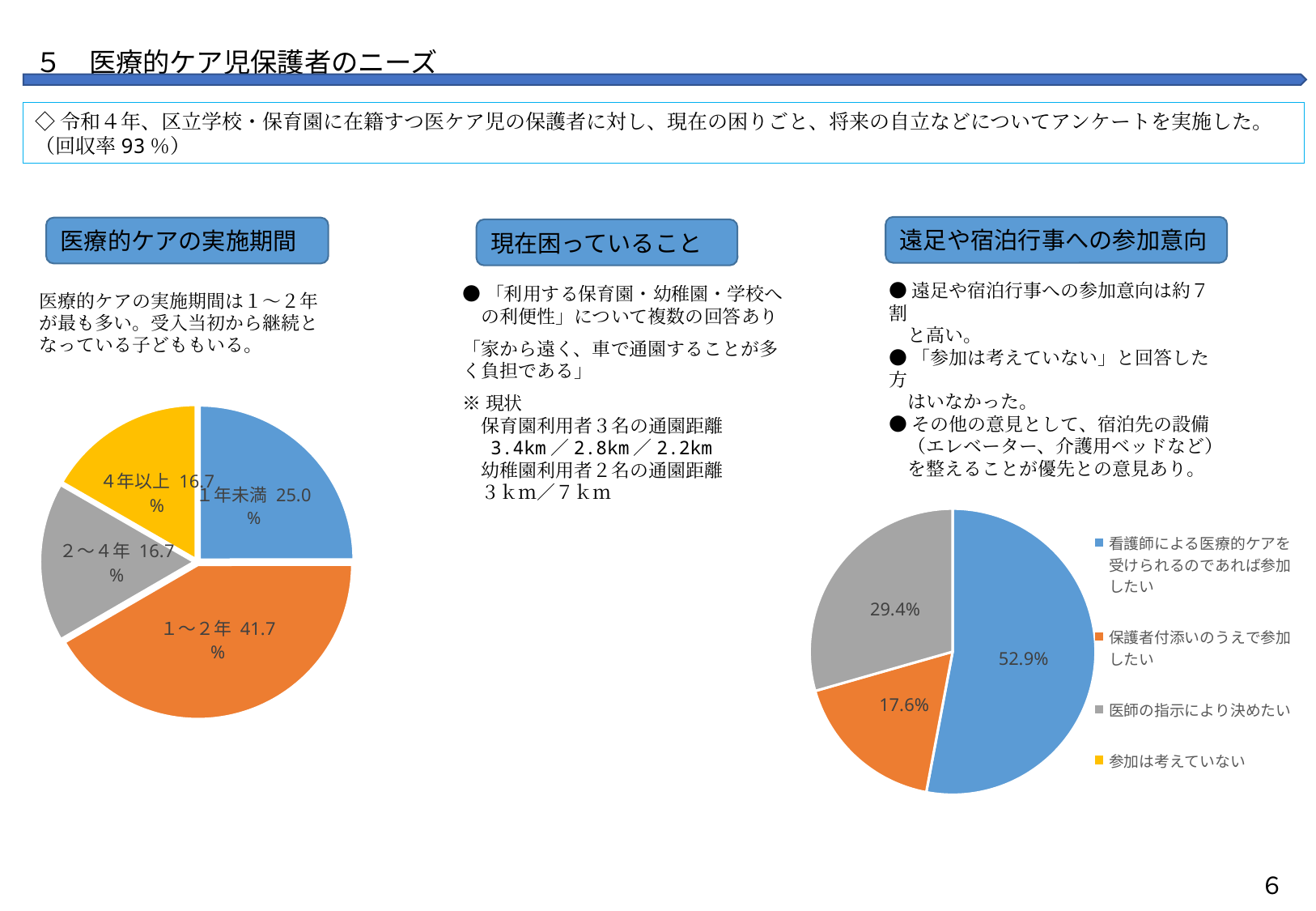
In the left pie chart (医療的ケアの実施期間), what is the difference between the shares for 1～2年 and 1年未満? 16.7% In the right pie chart (遠足や宿泊行事への参加意向), which is larger: 医師の指示により決めたい or 保護者付添いのうえで参加したい? 医師の指示により決めたい In the left pie chart (医療的ケアの実施期間), which category has the largest share? 1～2年 In the right pie chart (遠足や宿泊行事への参加意向), what is the share for 医師の指示により決めたい? 29.4% In the left pie chart (医療的ケアの実施期間), what is the share for 1～2年? 41.7% In the right pie chart (遠足や宿泊行事への参加意向), what is the share for 看護師による医療的ケアを受けられるのであれば参加したい? 52.9% In the right pie chart (遠足や宿泊行事への参加意向), what is the share for 保護者付添いのうえで参加したい? 17.6% In the left pie chart (医療的ケアの実施期間), what is the share for 1年未満? 25.0% What type of chart is used for 医療的ケアの実施期間? Pie chart In the right pie chart (遠足や宿泊行事への参加意向), how many entries does the legend list? 4 In the left pie chart (医療的ケアの実施期間), how many slices are shown? 4 In the right pie chart (遠足や宿泊行事への参加意向), what is the difference between the shares for 看護師による医療的ケアを受けられるのであれば参加したい and 医師の指示により決めたい? 23.5%